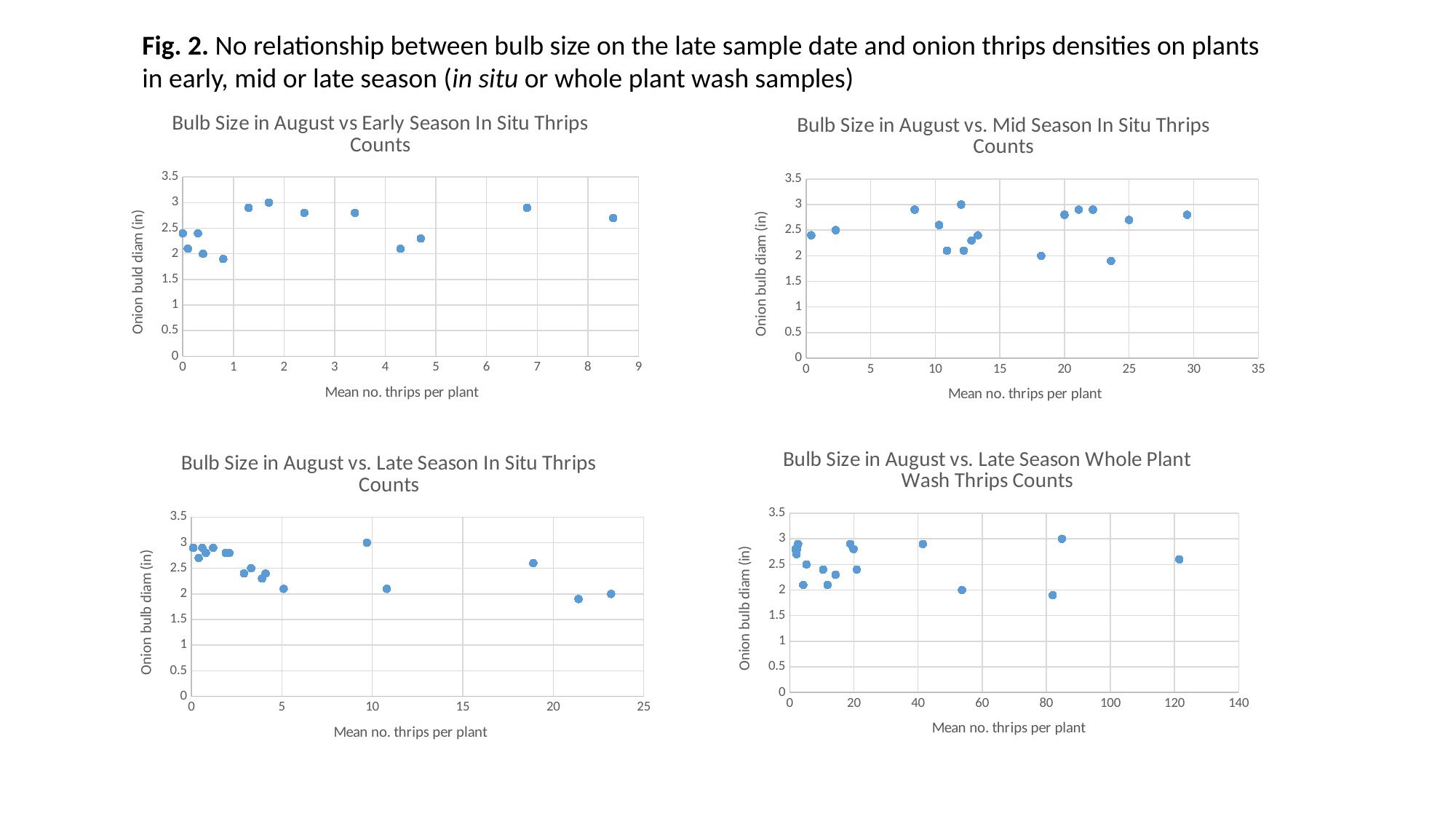
In the 'Bulb Size in August vs Early Season In Situ Thrips Counts' chart, is the bulb diameter of the point at about 8.5 thrips per plant greater or less than 2.5? greater How many data points are plotted in the 'Bulb Size in August vs Early Season In Situ Thrips Counts' chart? 13 How many charts are shown on the slide? 4 In the 'Bulb Size in August vs. Late Season In Situ Thrips Counts' chart, is the bulb diameter of the point at about 9.7 thrips per plant greater or less than 2.5? greater In the 'Bulb Size in August vs. Late Season Whole Plant Wash Thrips Counts' chart, is the bulb diameter of the point at about 120 thrips per plant greater or less than 2? greater What is the highest value shown on the x axis of the 'Bulb Size in August vs. Mid Season In Situ Thrips Counts' chart? 35 What is the x-axis title of the 'Bulb Size in August vs. Mid Season In Situ Thrips Counts' chart? Mean no. thrips per plant What is the y-axis title of the 'Bulb Size in August vs. Late Season Whole Plant Wash Thrips Counts' chart? Onion bulb diam (in) What kind of chart is the 'Bulb Size in August vs Early Season In Situ Thrips Counts' chart? scatter chart According to the figure caption, what relationship do the charts show between bulb size and thrips densities? No relationship